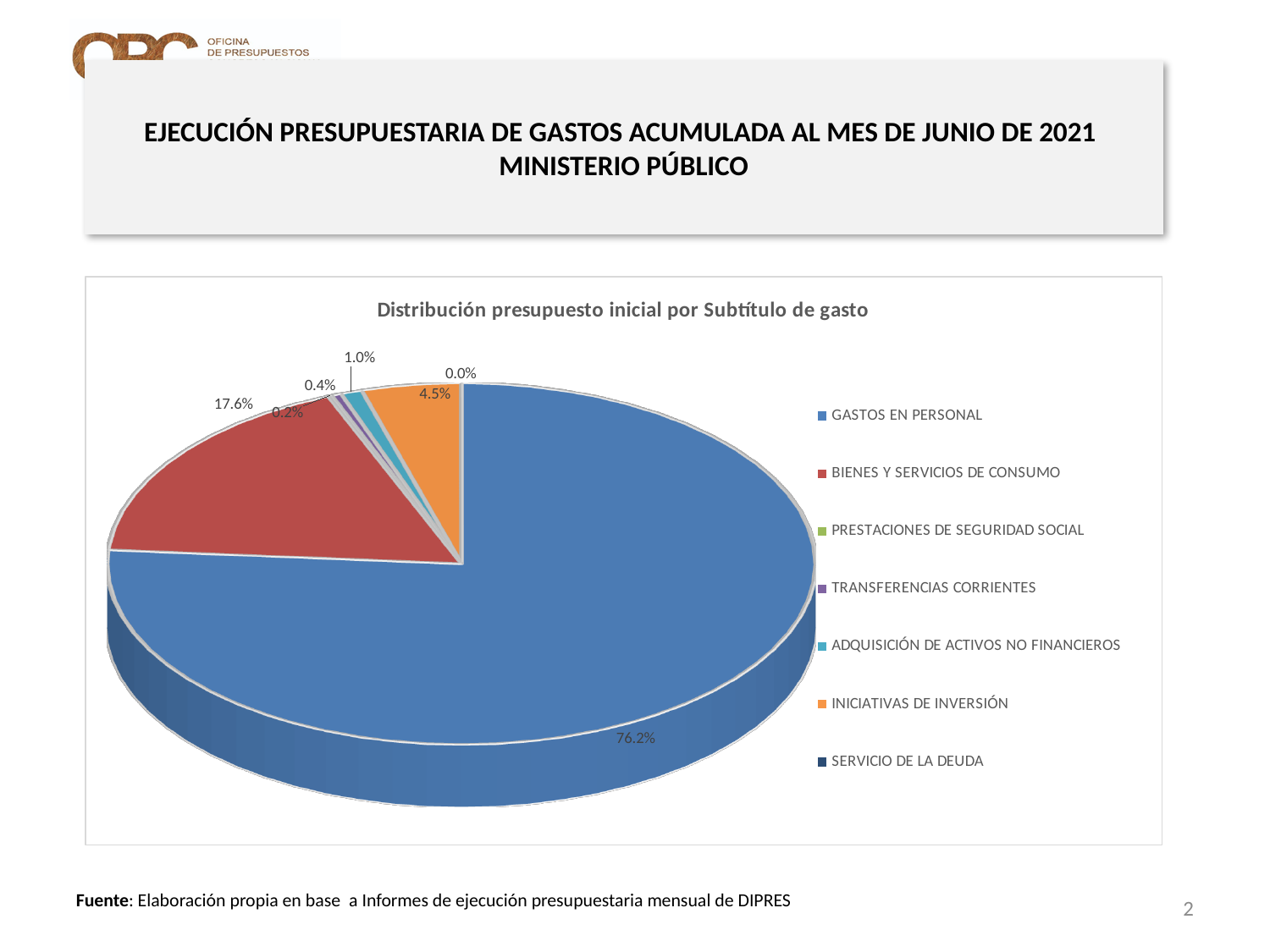
Which category has the smallest share of the pie? SERVICIO DE LA DEUDA What is the value shown for SERVICIO DE LA DEUDA? 0.0% How many categories does the pie chart's legend list? 7 What share of the pie does BIENES Y SERVICIOS DE CONSUMO represent? 17.6% Which is larger, the share for INICIATIVAS DE INVERSIÓN or the share for ADQUISICIÓN DE ACTIVOS NO FINANCIEROS? INICIATIVAS DE INVERSIÓN What kind of chart is shown on the slide? pie chart What is the difference in percentage points between GASTOS EN PERSONAL and BIENES Y SERVICIOS DE CONSUMO? 58.6 What is the value shown for INICIATIVAS DE INVERSIÓN? 4.5% Which category has the largest share of the pie? GASTOS EN PERSONAL What is the value shown for ADQUISICIÓN DE ACTIVOS NO FINANCIEROS? 1.0% What is the title of the chart? Distribución presupuesto inicial por Subtítulo de gasto What share of the pie does GASTOS EN PERSONAL represent? 76.2%